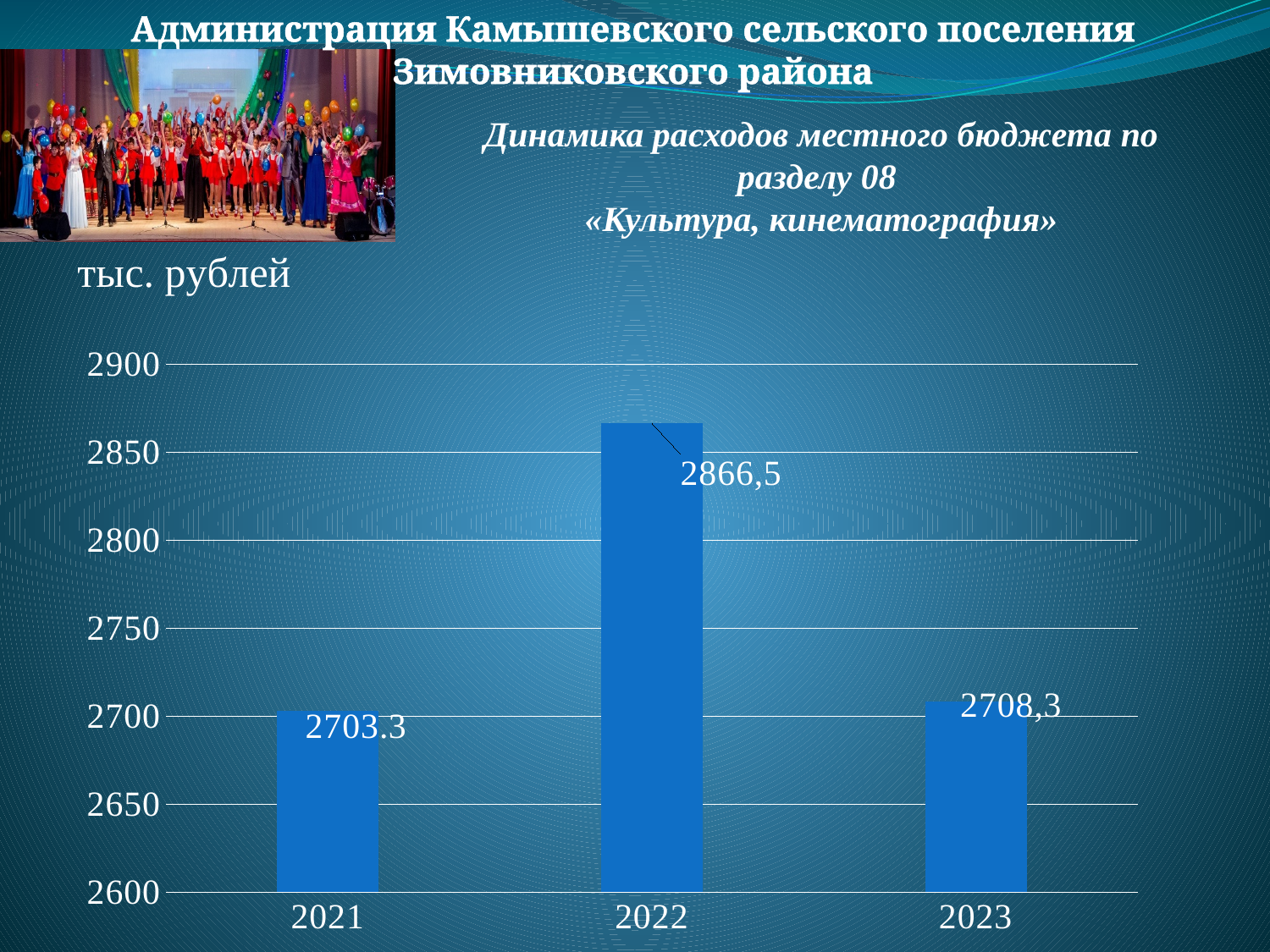
Which year has the highest expenditure on the chart? 2022 What is the difference between the values for 2022 and 2021? 163,2 What is the difference between the values for 2022 and 2023? 158,2 What is the value for 2023 on the chart? 2708,3 How many years are shown on the chart? 3 What kind of chart is shown on the slide? bar chart Which is larger, the value for 2023 or the value for 2021? 2023 What is the value for 2022 on the chart? 2866,5 In what units are the values on the chart expressed? тыс. рублей Which year has the lowest expenditure on the chart? 2021 Is the value for 2022 greater or less than 2850? greater What is the value for 2021 on the chart? 2703.3